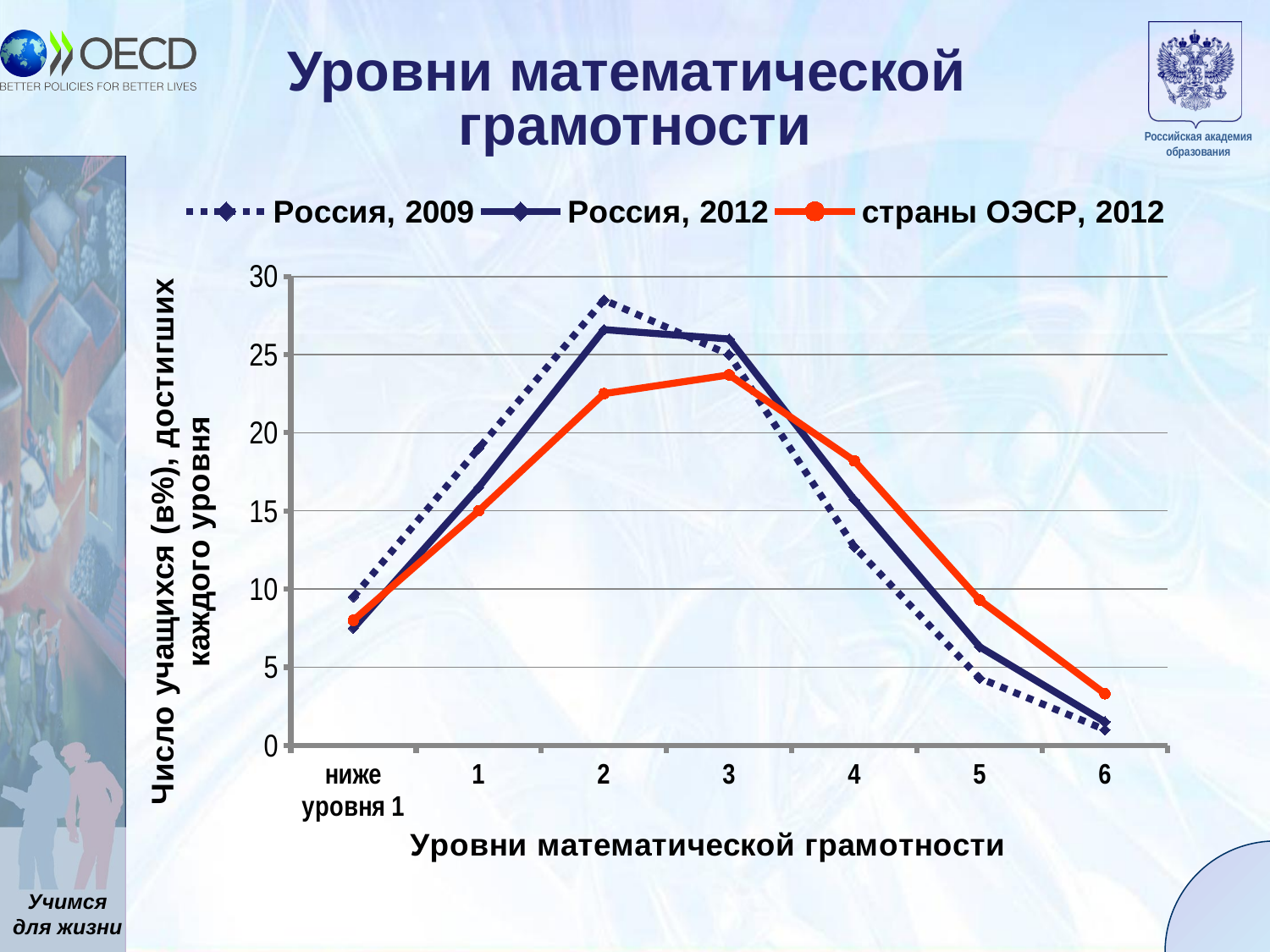
At which level does the Россия, 2009 series reach its highest value? 2 Is the value for страны ОЭСР, 2012 at level 6 greater or less than 5? less Is the value for Россия, 2012 at level 5 greater or less than 10? less Is the value for Россия, 2009 at level 2 greater or less than 25? greater At level 4, which series has the larger value: Россия, 2009 or страны ОЭСР, 2012? страны ОЭСР, 2012 How many levels (categories) are shown along the x axis? 7 What kind of chart is shown on the slide? line chart What is the title of the chart? Уровни математической грамотности How many series does the legend list? 3 Do the values for Россия, 2012 rise or fall from level 3 to level 6? fall At which level does the страны ОЭСР, 2012 series have its lowest value? 6